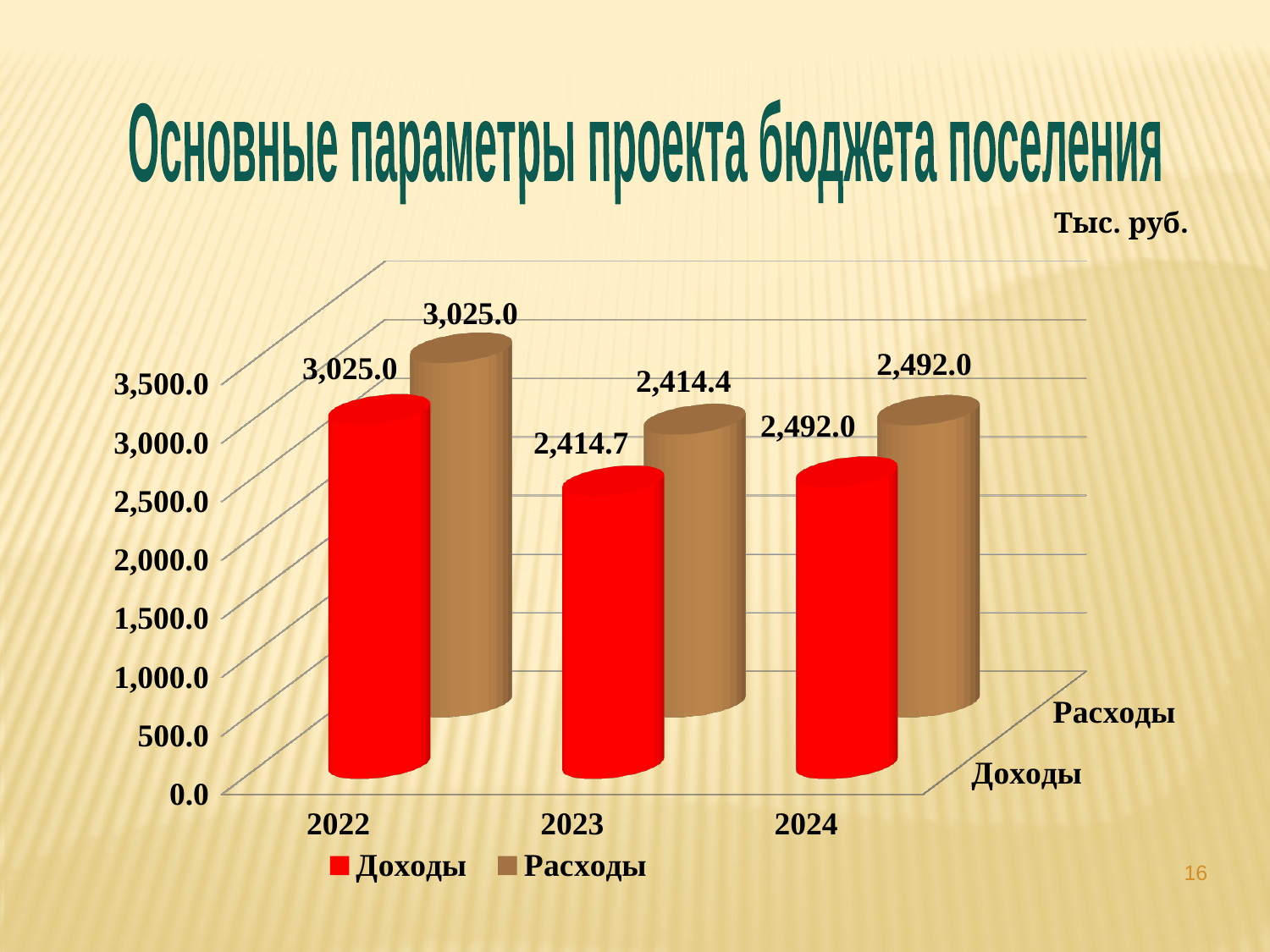
What is the value of Доходы for 2022? 3,025.0 What is the value of Расходы for 2024? 2,492.0 What is the value of Доходы for 2024? 2,492.0 What is the difference between Доходы in 2022 and Доходы in 2023? 610.3 What kind of chart is shown on the slide? Bar chart How many series does the legend list? 2 Which year has the highest value of Доходы? 2022 Which year has the lowest value of Расходы? 2023 What is the value of Расходы for 2023? 2,414.4 Which is larger: Доходы in 2024 or Доходы in 2023? Доходы in 2024 How many years are shown on the x axis? 3 What is the difference between Расходы in 2024 and Расходы in 2023? 77.6